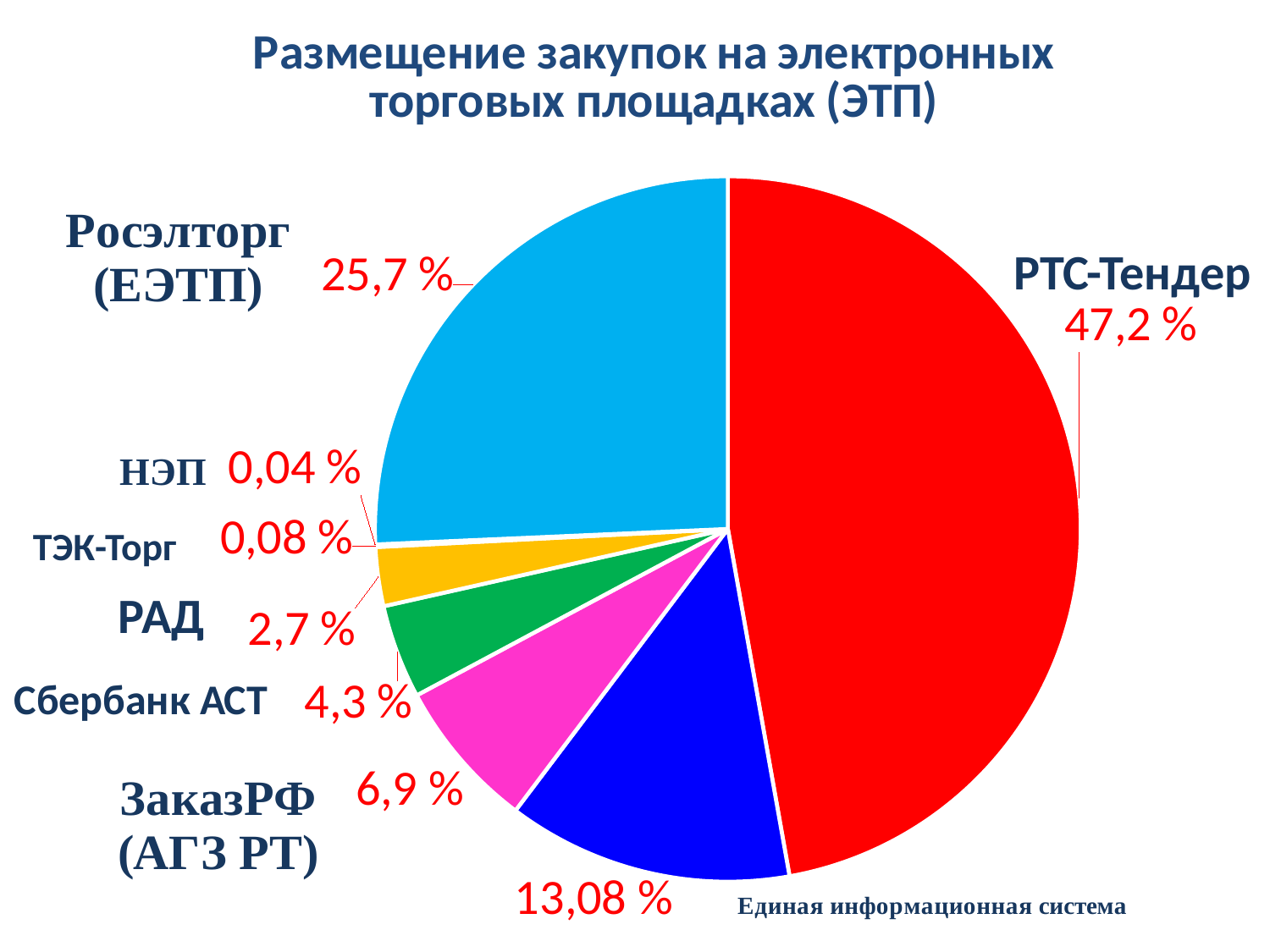
What share is shown for Росэлторг (ЕЭТП)? 25,7 % What share is shown for РАД? 2,7 % Which has a larger share, Росэлторг (ЕЭТП) or ЗаказРФ (АГЗ РТ)? Росэлторг (ЕЭТП) What share is shown for Сбербанк АСТ? 4,3 % Which platform has the smallest share of the pie? НЭП What share is shown for НЭП? 0,04 % What kind of chart is shown on the slide? pie chart What share is shown for ЗаказРФ (АГЗ РТ)? 6,9 % What share is shown for ТЭК-Торг? 0,08 % Which platform has the largest share of the pie? РТС-Тендер What is the title of the chart? Размещение закупок на электронных торговых площадках (ЭТП) What share is shown for РТС-Тендер? 47,2 %